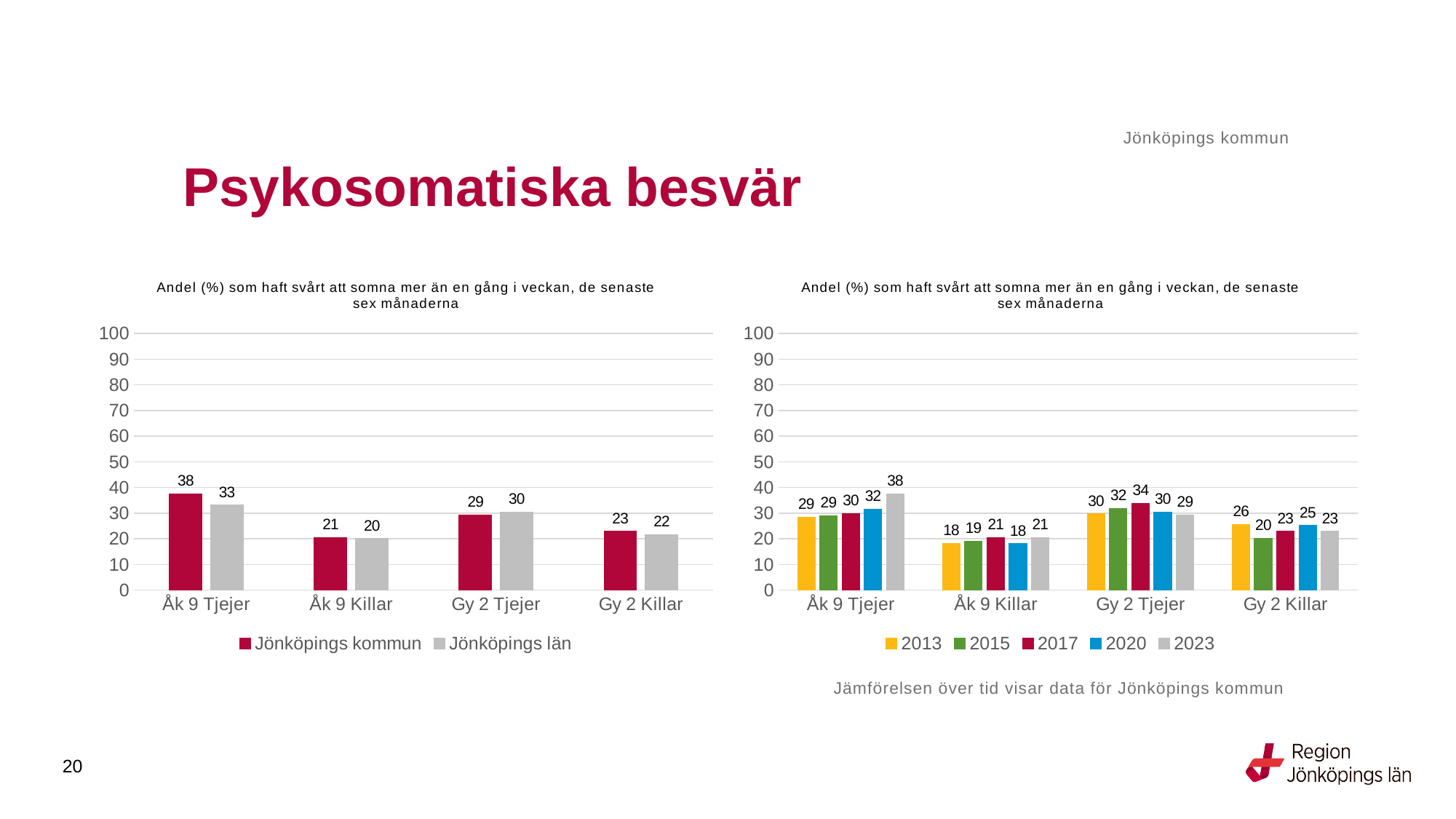
In the left chart, what is the value for Jönköpings kommun for Åk 9 Tjejer? 38 In the right chart, which is larger for Gy 2 Tjejer: the value for 2017 or the value for 2023? 2017 In the right chart, how many series does the legend list? 5 In the left chart, what is the value for Jönköpings län for Gy 2 Tjejer? 30 In the right chart, what is the value for 2023 for Åk 9 Tjejer? 38 In the right chart, which year has the lowest value for Gy 2 Killar? 2015 In the left chart, what is the difference between Jönköpings kommun and Jönköpings län for Åk 9 Tjejer? 5 In the right chart, how many categories are shown on the x axis? 4 What kind of chart is the right chart? Bar chart In the left chart, how many series does the legend list? 2 In the left chart, which category has the highest value for Jönköpings kommun? Åk 9 Tjejer In the right chart, what is the value for 2013 for Gy 2 Killar? 26